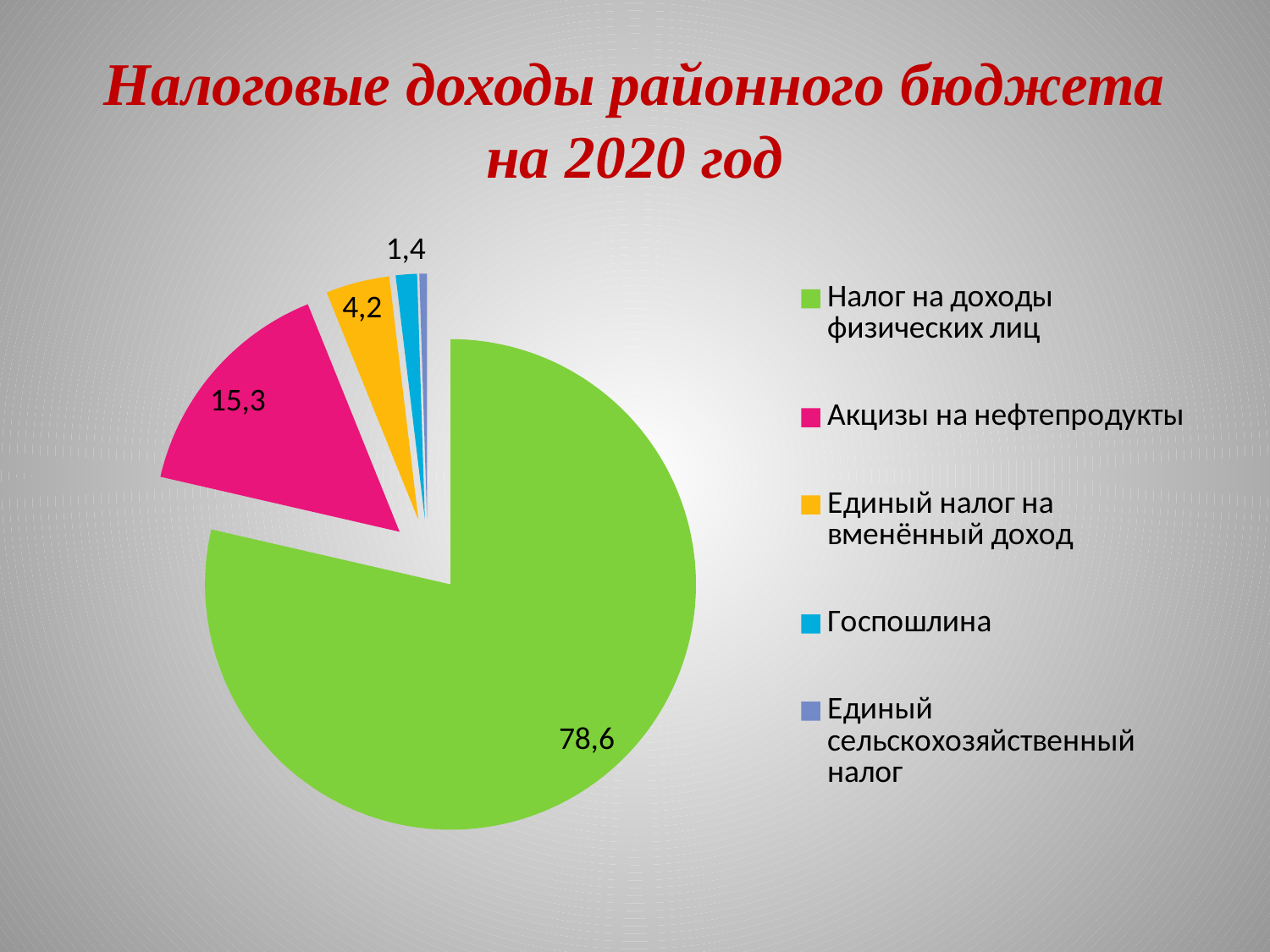
What is the difference between the values for Акцизы на нефтепродукты and Единый налог на вменённый доход? 11,1 What value is shown for Единый налог на вменённый доход? 4,2 Which category has the smallest slice of the pie? Единый сельскохозяйственный налог What is the difference between the values for Налог на доходы физических лиц and Акцизы на нефтепродукты? 63,3 Which category has the largest slice of the pie? Налог на доходы физических лиц Which is larger: the value for Единый налог на вменённый доход or the value for Госпошлина? Единый налог на вменённый доход How many categories does the legend list? 5 What is the title of the slide? Налоговые доходы районного бюджета на 2020 год What value is shown for Налог на доходы физических лиц? 78,6 What value is shown for Акцизы на нефтепродукты? 15,3 What value is shown for Госпошлина? 1,4 What kind of chart is shown on the slide? Pie chart